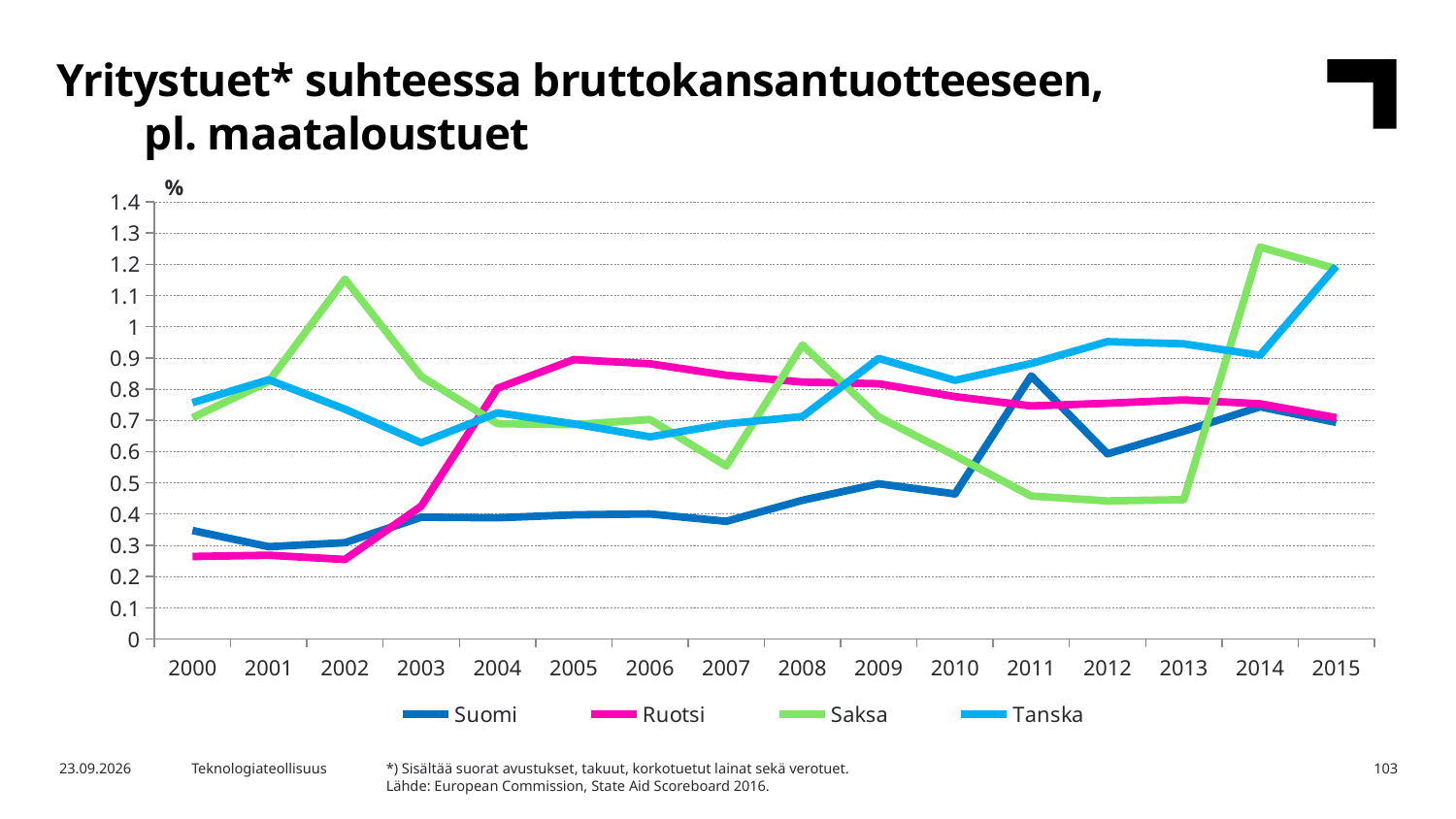
Is the value for Ruotsi in 2000 greater or less than 0.3? less Is the value for Saksa in 2002 greater or less than 1? greater In which year does Saksa reach its highest value? 2014 Is the value for Tanska in 2012 greater or less than 0.9? greater In 2011, which is larger: the value for Suomi or the value for Ruotsi? Suomi Which country has the lowest value in 2002? Ruotsi In 2007, which is larger: the value for Saksa or the value for Tanska? Tanska How many years are shown on the x axis? 16 What type of chart is shown on the slide? Line chart Which country has the highest value in 2014? Saksa How many series does the legend list? 4 What unit is shown at the top of the y axis? %